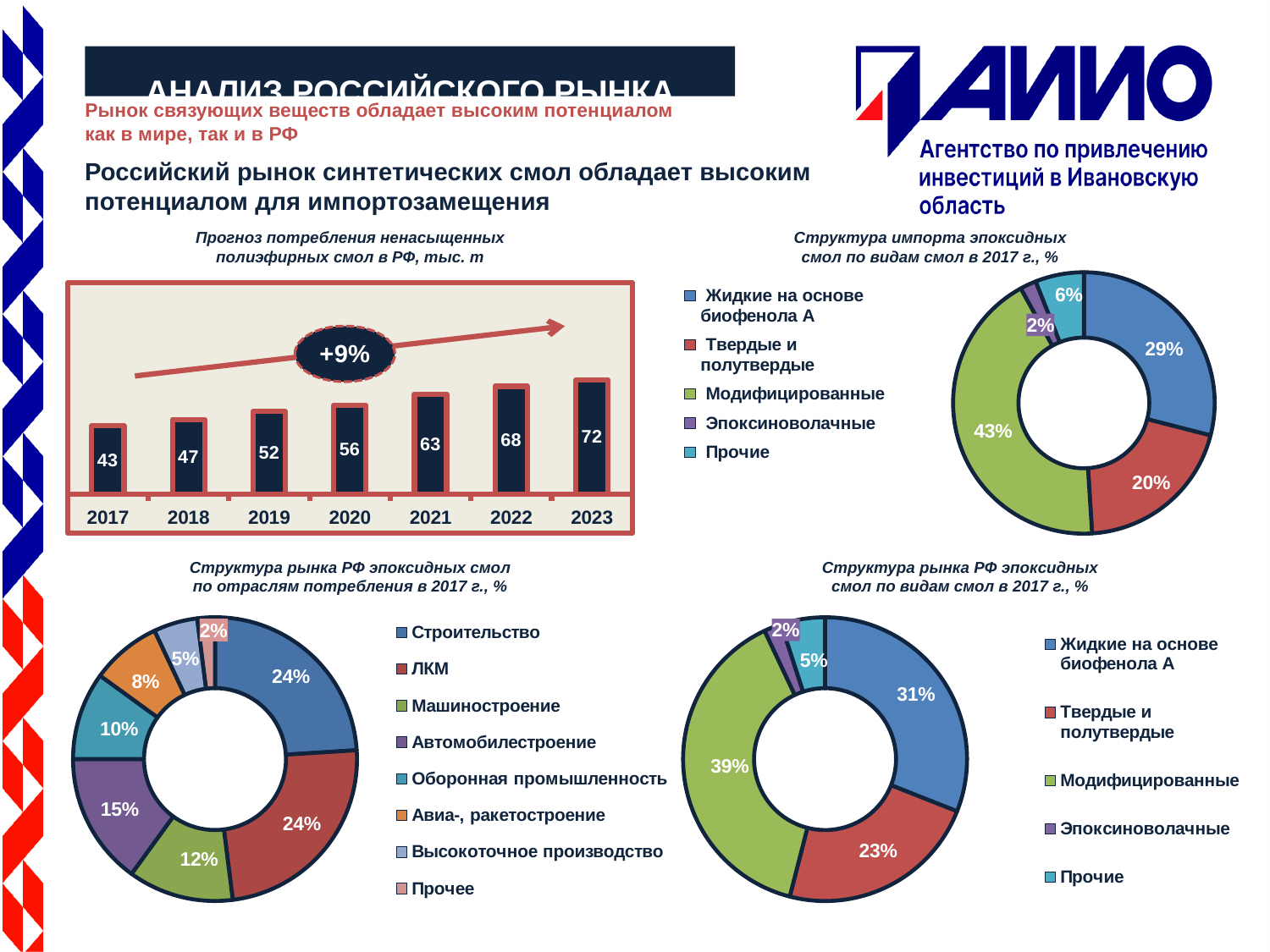
What type of chart is 'Прогноз потребления ненасыщенных полиэфирных смол в РФ, тыс. т'? bar chart In the chart 'Структура рынка РФ эпоксидных смол по видам смол в 2017 г., %', which is larger: 'Жидкие на основе биофенола А' or 'Твердые и полутвердые'? Жидкие на основе биофенола А In the chart 'Прогноз потребления ненасыщенных полиэфирных смол в РФ, тыс. т', do the values rise or fall from 2017 to 2023? rise In the chart 'Структура импорта эпоксидных смол по видам смол в 2017 г., %', what is the share of 'Модифицированные'? 43% In the chart 'Структура рынка РФ эпоксидных смол по отраслям потребления в 2017 г., %', what is the share of 'Автомобилестроение'? 15% In the chart 'Прогноз потребления ненасыщенных полиэфирных смол в РФ, тыс. т', what is the value for 2020? 56 In the chart 'Прогноз потребления ненасыщенных полиэфирных смол в РФ, тыс. т', what is the difference between the values for 2023 and 2017? 29 How many years are shown in the chart 'Прогноз потребления ненасыщенных полиэфирных смол в РФ, тыс. т'? 7 How many categories does the legend list in the chart 'Структура рынка РФ эпоксидных смол по отраслям потребления в 2017 г., %'? 8 In the chart 'Прогноз потребления ненасыщенных полиэфирных смол в РФ, тыс. т', which year has the highest value? 2023 In the chart 'Структура импорта эпоксидных смол по видам смол в 2017 г., %', which category has the smallest share? Эпоксиноволачные In the chart 'Структура рынка РФ эпоксидных смол по видам смол в 2017 г., %', what is the difference between the shares of 'Модифицированные' and 'Прочие'? 34%